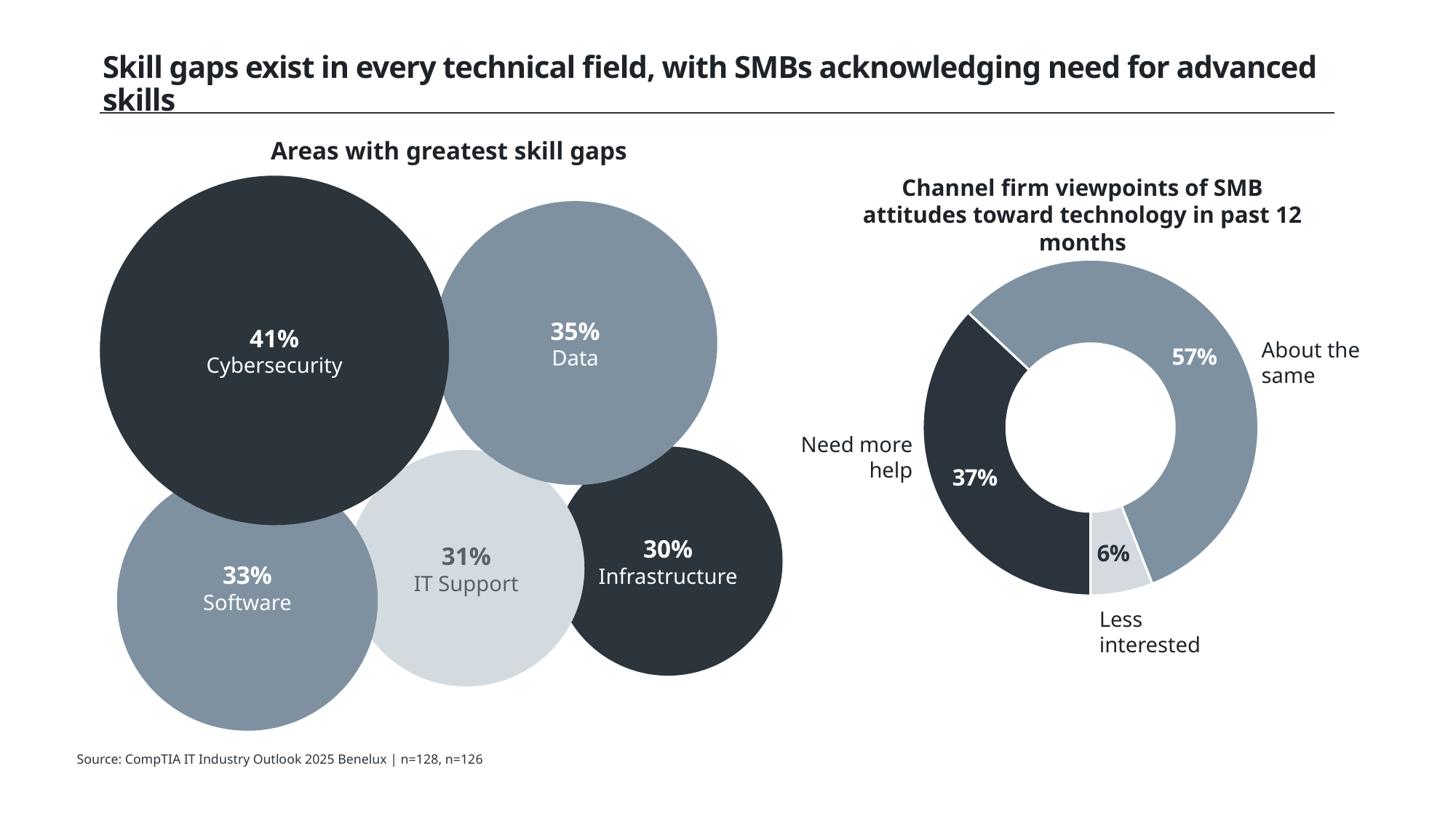
In the 'Channel firm viewpoints of SMB attitudes toward technology in past 12 months' chart, what is the value for 'Need more help'? 37% In the 'Channel firm viewpoints of SMB attitudes toward technology in past 12 months' chart, what is the difference between 'About the same' and 'Need more help'? 20% In the 'Areas with greatest skill gaps' chart, what is the value for Cybersecurity? 41% In the 'Areas with greatest skill gaps' chart, which is larger, Software or Infrastructure? Software In the 'Areas with greatest skill gaps' chart, which area has the highest value? Cybersecurity How many categories does the 'Channel firm viewpoints of SMB attitudes toward technology in past 12 months' chart show? 3 In the 'Channel firm viewpoints of SMB attitudes toward technology in past 12 months' chart, which category has the smallest share? Less interested What kind of chart is the 'Channel firm viewpoints of SMB attitudes toward technology in past 12 months' chart? Doughnut chart In the 'Areas with greatest skill gaps' chart, what is the difference between Cybersecurity and Data? 6% In the 'Areas with greatest skill gaps' chart, what is the value for IT Support? 31% How many areas are shown in the 'Areas with greatest skill gaps' chart? 5 In the 'Areas with greatest skill gaps' chart, which area has the lowest value? Infrastructure